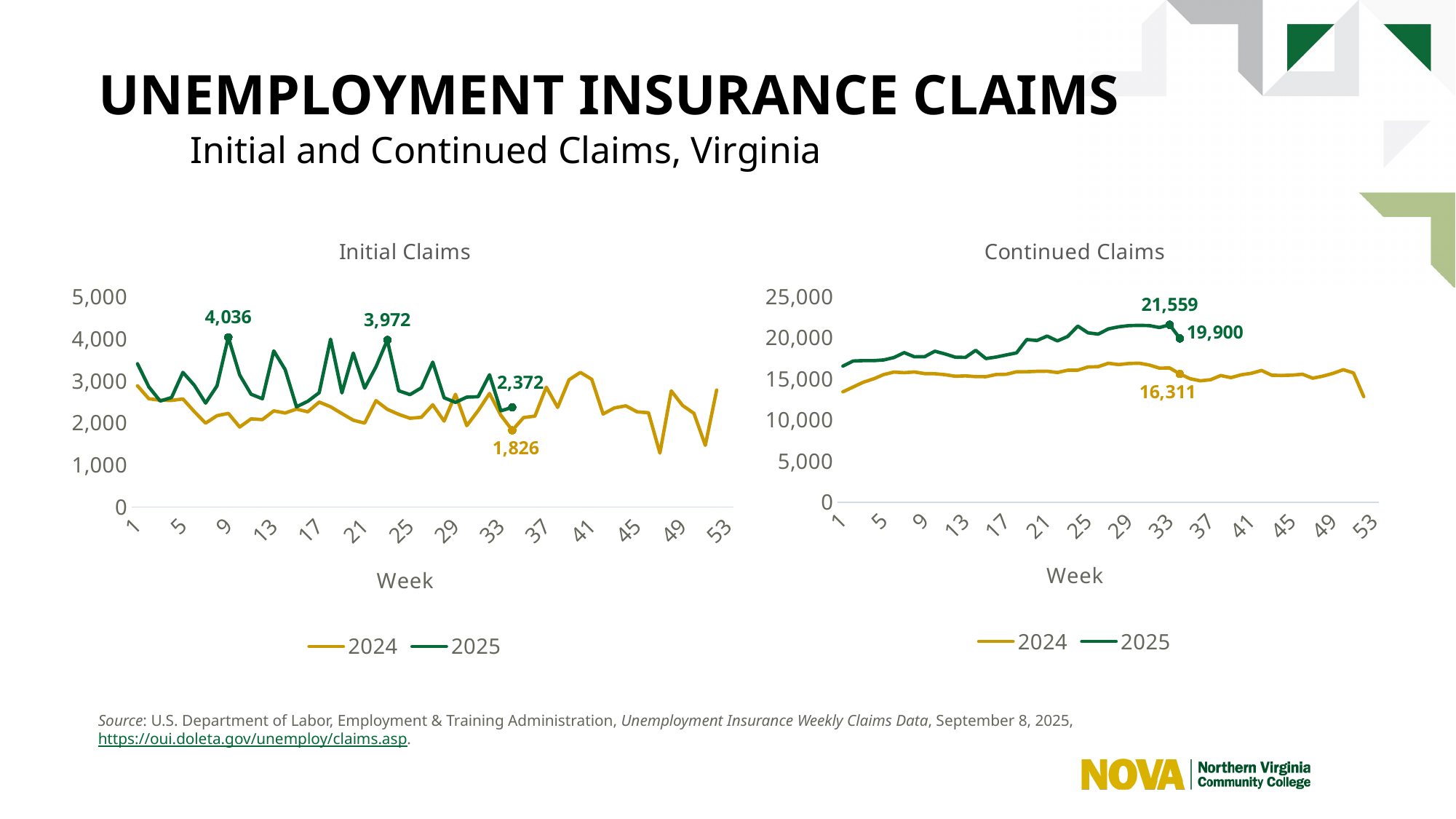
In the Continued Claims chart, what is the highest labeled value on the 2025 line? 21,559 In the Continued Claims chart, what is the difference between the labeled peak of the 2025 line (21,559) and its labeled end value (19,900)? 1,659 How many series does the legend of the Continued Claims chart list? 2 In the Initial Claims chart, what is the value labeled at the end of the 2025 line? 2,372 What kind of chart is the Initial Claims chart? line chart In the Initial Claims chart, what value is labeled on the 2024 line? 1,826 In the Initial Claims chart, what is the highest labeled value on the 2025 line? 4,036 In the Continued Claims chart, what value is labeled on the 2024 line? 16,311 In the Continued Claims chart, which series has the higher labeled value at the end of the 2025 line, 2024 or 2025? 2025 In the Initial Claims chart, is the lowest point of the 2024 line greater or less than 2,000? less In the Continued Claims chart, what is the value labeled at the end of the 2025 line? 19,900 In the Initial Claims chart, what is the difference between the labeled end value of the 2025 line (2,372) and the labeled 2024 value (1,826)? 546